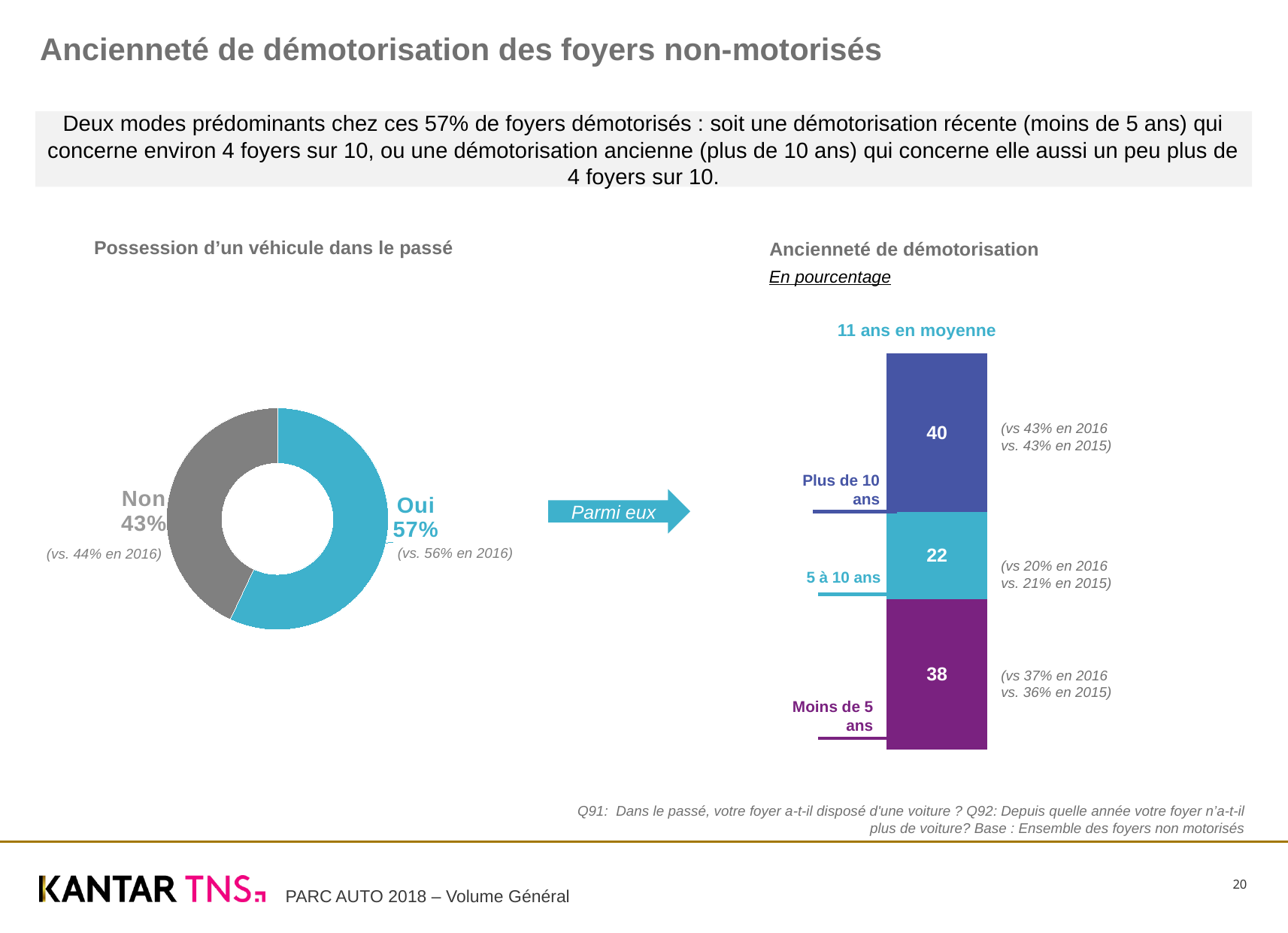
In the chart 'Ancienneté de démotorisation', which category has the lowest value? 5 à 10 ans What kind of chart is 'Ancienneté de démotorisation'? Stacked bar chart In the chart 'Ancienneté de démotorisation', what is the value for '5 à 10 ans'? 22 In the chart 'Possession d'un véhicule dans le passé', what is the difference in percentage points between 'Oui' and 'Non'? 14 In the chart 'Possession d'un véhicule dans le passé', which slice is larger, 'Oui' or 'Non'? Oui In the chart 'Possession d'un véhicule dans le passé', what share of households answered 'Oui'? 57% In the chart 'Ancienneté de démotorisation', what is the value for 'Plus de 10 ans'? 40 How many categories are shown in the chart 'Ancienneté de démotorisation'? 3 What kind of chart is 'Possession d'un véhicule dans le passé'? Pie (donut) chart In the chart 'Ancienneté de démotorisation', what is the value for 'Moins de 5 ans'? 38 In the chart 'Possession d'un véhicule dans le passé', what share of households answered 'Non'? 43% In the chart 'Ancienneté de démotorisation', what is the total of the stacked bar? 100